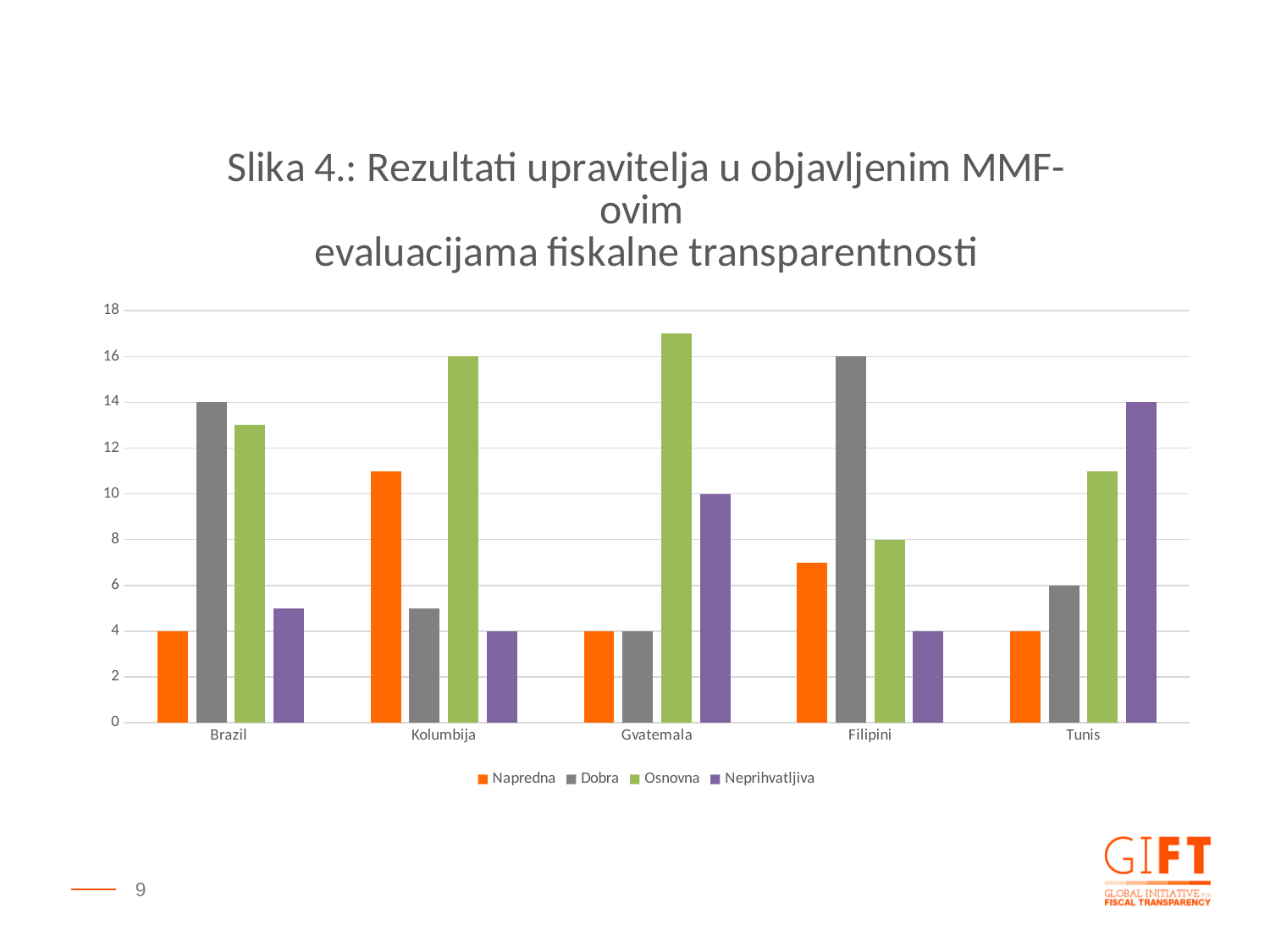
What type of chart is shown on the slide? bar chart Which is larger for Tunis, Dobra or Neprihvatljiva? Neprihvatljiva What is the value of Neprihvatljiva for Tunis? 14 What is the value of Dobra for Brazil? 14 How many series does the legend list? 4 How many countries are shown on the x axis? 5 Which country has the highest Dobra value? Filipini What is the value of Osnovna for Kolumbija? 16 What is the value of Dobra for Filipini? 16 Is the value of Napredna for Kolumbija greater or less than 10? greater What is the value of Neprihvatljiva for Gvatemala? 10 Is the value of Osnovna for Gvatemala greater or less than 16? greater